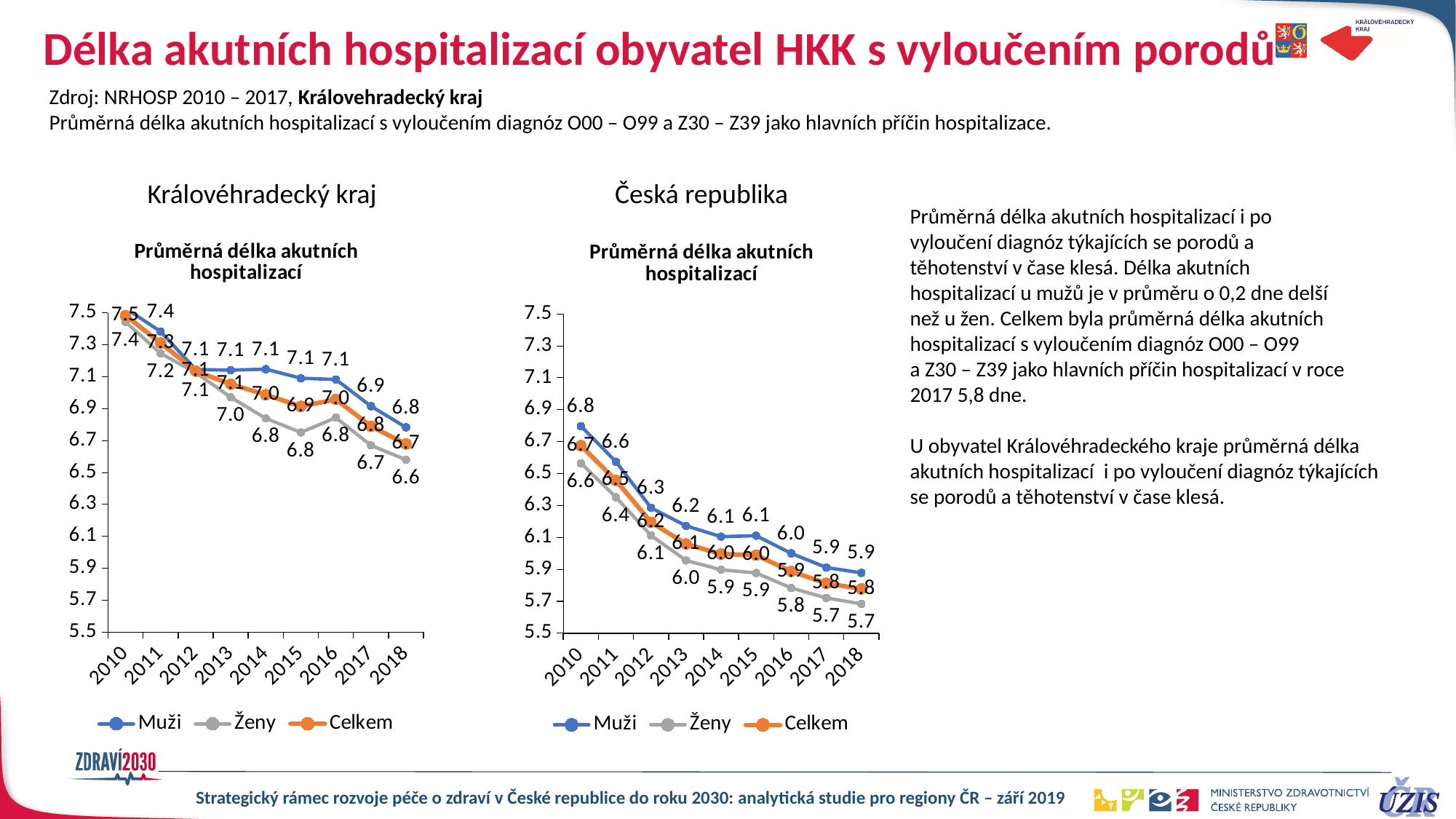
In the Královéhradecký kraj chart, what is the value for Muži in 2010? 7.5 How many series does the legend of the Česká republika chart list? 3 What kind of chart is the Královéhradecký kraj chart? line chart In the Česká republika chart, what is the value for Celkem in 2018? 5.8 In the Královéhradecký kraj chart, which is larger in 2015: Muži or Ženy? Muži In the Královéhradecký kraj chart, which series has the highest value in 2018? Muži In the Česká republika chart, which series has the lowest value in 2018? Ženy In the Česká republika chart, do the Muži values rise or fall from 2010 to 2018? fall In the Královéhradecký kraj chart, what is the value for Ženy in 2018? 6.6 In the Česká republika chart, what is the value for Muži in 2012? 6.3 In the Česká republika chart, what is the difference between Muži and Ženy in 2010? 0.2 How many years are plotted on the x axis of the Královéhradecký kraj chart? 9